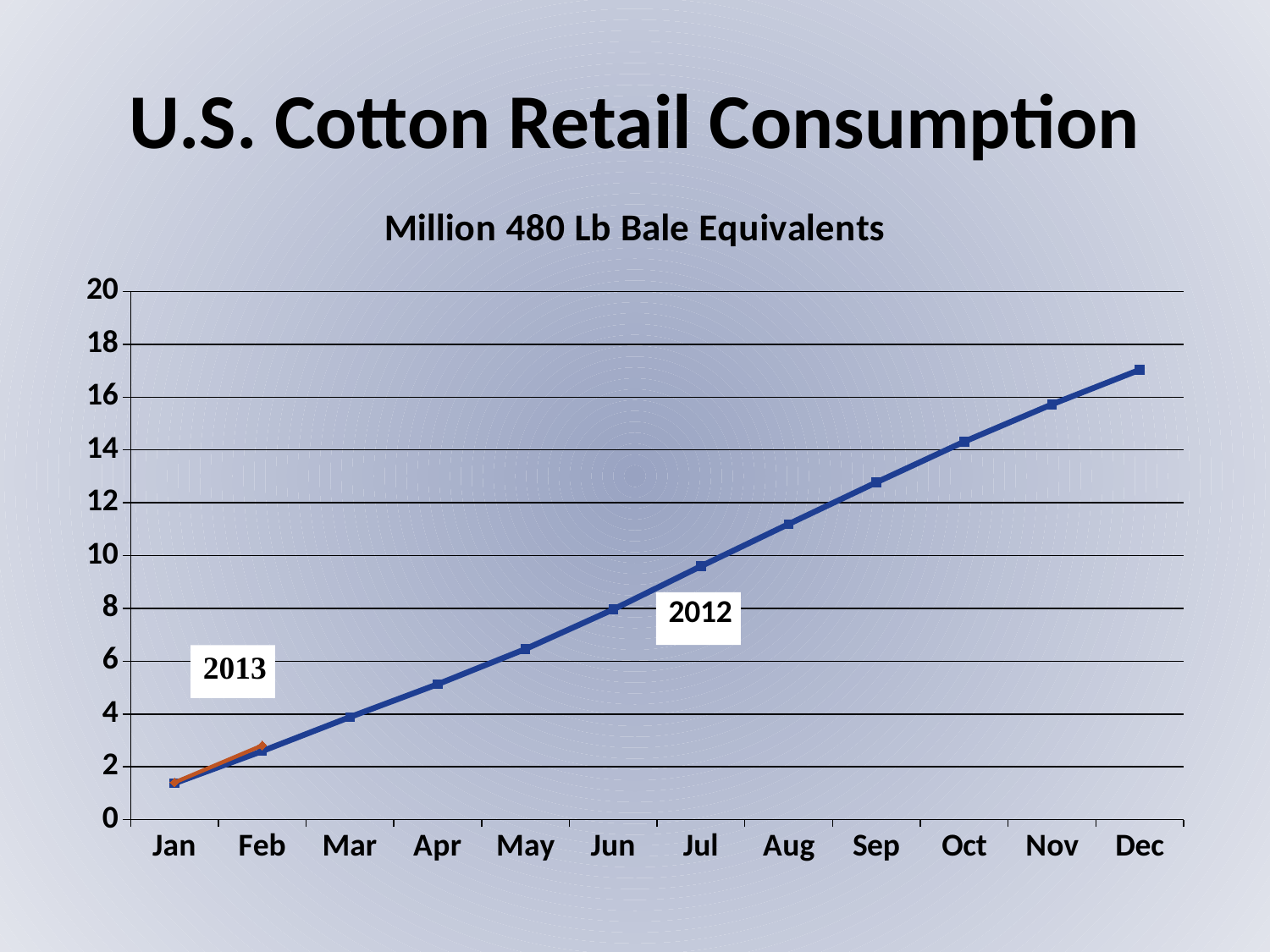
Is the 2012 value for Jul greater or less than 8? greater Which is larger for 2012, the value for Sep or the value for Apr? Sep Is the 2012 value for Jan greater or less than 2? less Which month has the lowest value for the 2012 series? Jan Do the 2012 values rise or fall from Jan to Dec? rise How many months are plotted along the x axis? 12 What unit is given in the chart subtitle? Million 480 Lb Bale Equivalents Is the 2012 value for Dec greater or less than 16? greater How many data series are labelled on the chart? 2 Which month has the highest value for the 2012 series? Dec What kind of chart is shown on the slide? line chart